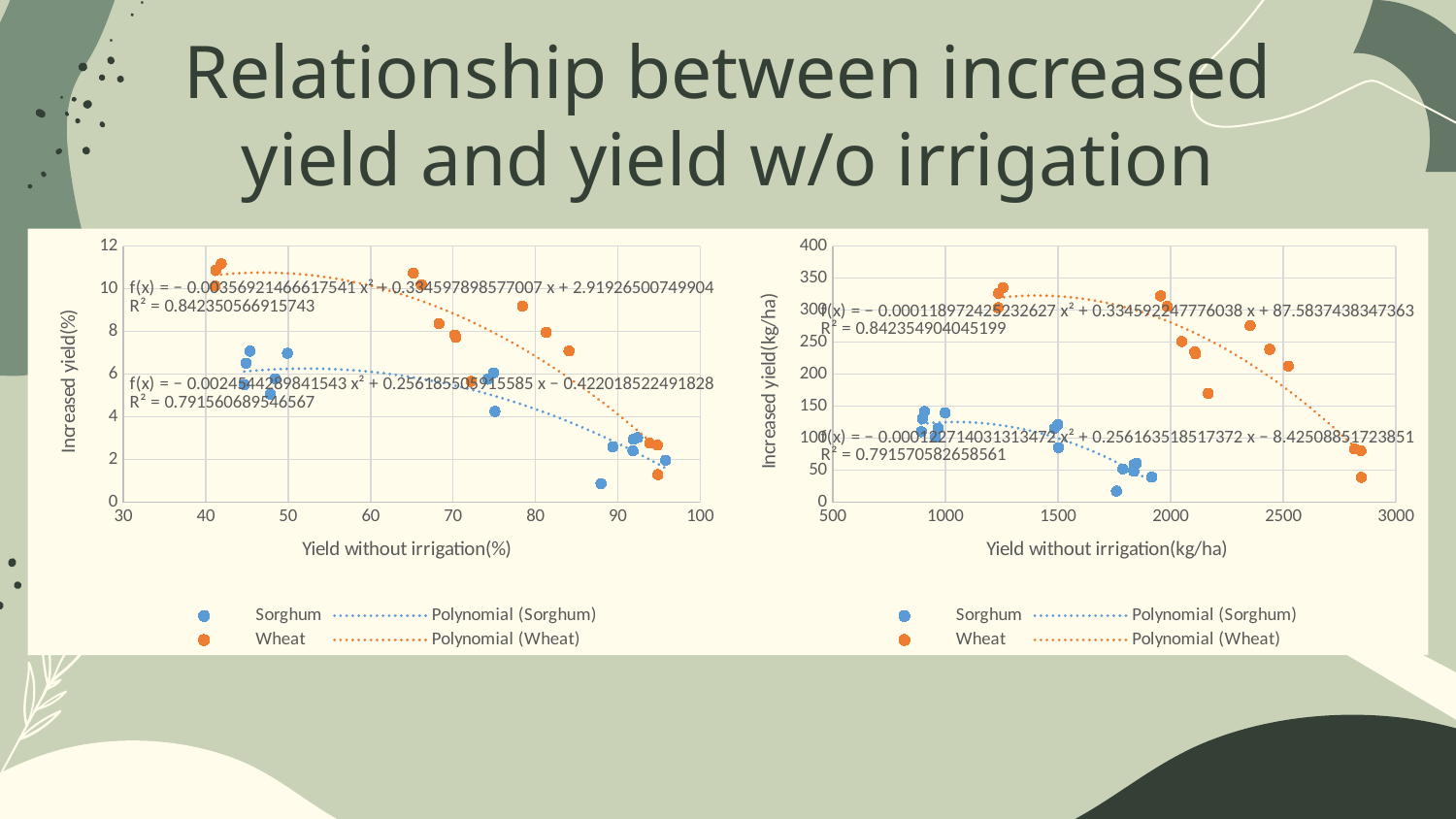
In the right chart, is the increased yield for the Wheat point near 1250 kg/ha yield without irrigation greater or less than 300? greater In the left chart, are the Wheat points near 41% yield without irrigation greater or less than 10 on the increased yield axis? greater In the left chart, does the Wheat polynomial trendline rise or fall as yield without irrigation increases? fall What kind of chart is the left chart on the slide? scatter chart In the right chart, does the Sorghum polynomial trendline rise or fall as yield without irrigation increases? fall What is the x-axis label of the right chart? Yield without irrigation(kg/ha) In the right chart, which series reaches the highest increased yield values, Sorghum or Wheat? Wheat In the left chart, is the increased yield for the Sorghum point at about 88% yield without irrigation greater or less than 2? less In the left chart, which series has the lower increased yield values overall, Sorghum or Wheat? Sorghum How many entries does the legend of the right chart list? 4 What is the R² value shown for the Wheat trendline in the left chart? 0.842350566915743